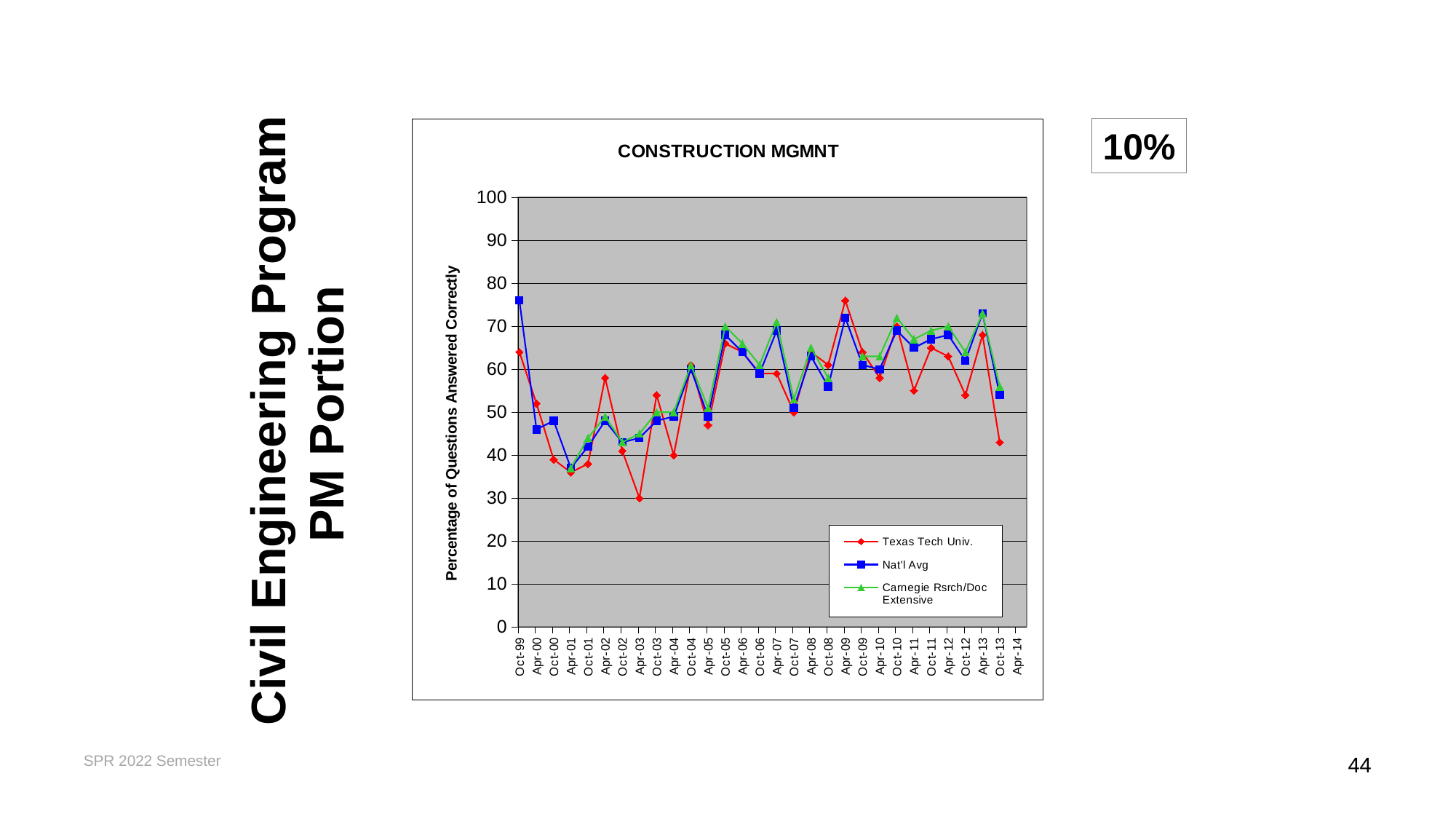
Is the Texas Tech Univ. value at Apr-03 greater or less than 40? less What is the title of the chart? CONSTRUCTION MGMNT At which date does the Texas Tech Univ. series reach its lowest value? Apr-03 How many series does the chart's legend list? 3 Does the Texas Tech Univ. series rise or fall from Oct-99 to Apr-01? fall Is the Nat'l Avg value at Oct-99 greater or less than 70? greater At which date does the Texas Tech Univ. series reach its highest value? Apr-09 What is the label of the vertical axis? Percentage of Questions Answered Correctly At Apr-09, which is larger: the Texas Tech Univ. value or the Nat'l Avg value? Texas Tech Univ. At Oct-13, which is larger: the Texas Tech Univ. value or the Nat'l Avg value? Nat'l Avg What type of chart is shown on the slide? line chart Is the Texas Tech Univ. value at Oct-13 greater or less than 50? less